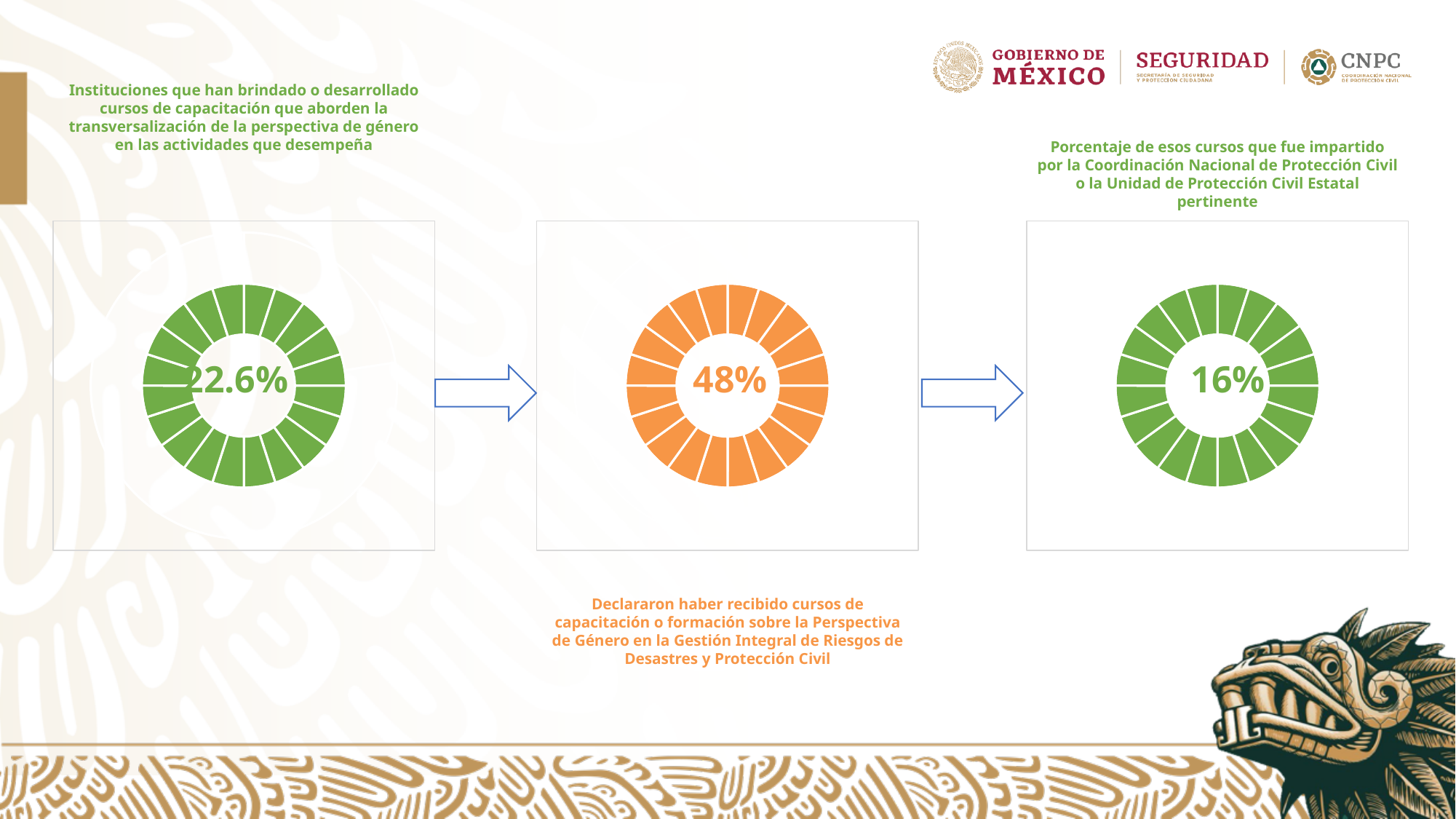
How many charts are shown on the slide? 3 What is the difference between the value in the left chart and the value in the right chart? 6.6% What value is shown in the centre of the left chart on the slide? 22.6% What colour are the left and right charts on the slide? Green What value is shown in the centre of the right chart on the slide? 16% What value is shown in the centre of the middle (orange) chart on the slide? 48% What is the difference between the value in the middle chart and the value in the right chart? 32% What kind of chart is used on the slide to display the percentages? Donut (ring) chart Which of the three charts on the slide shows the highest percentage? The middle chart (48%) Which of the three charts on the slide shows the lowest percentage? The right chart (16%) What colour is the middle chart on the slide? Orange Which is larger, the value in the left chart or the value in the right chart? The left chart (22.6%)